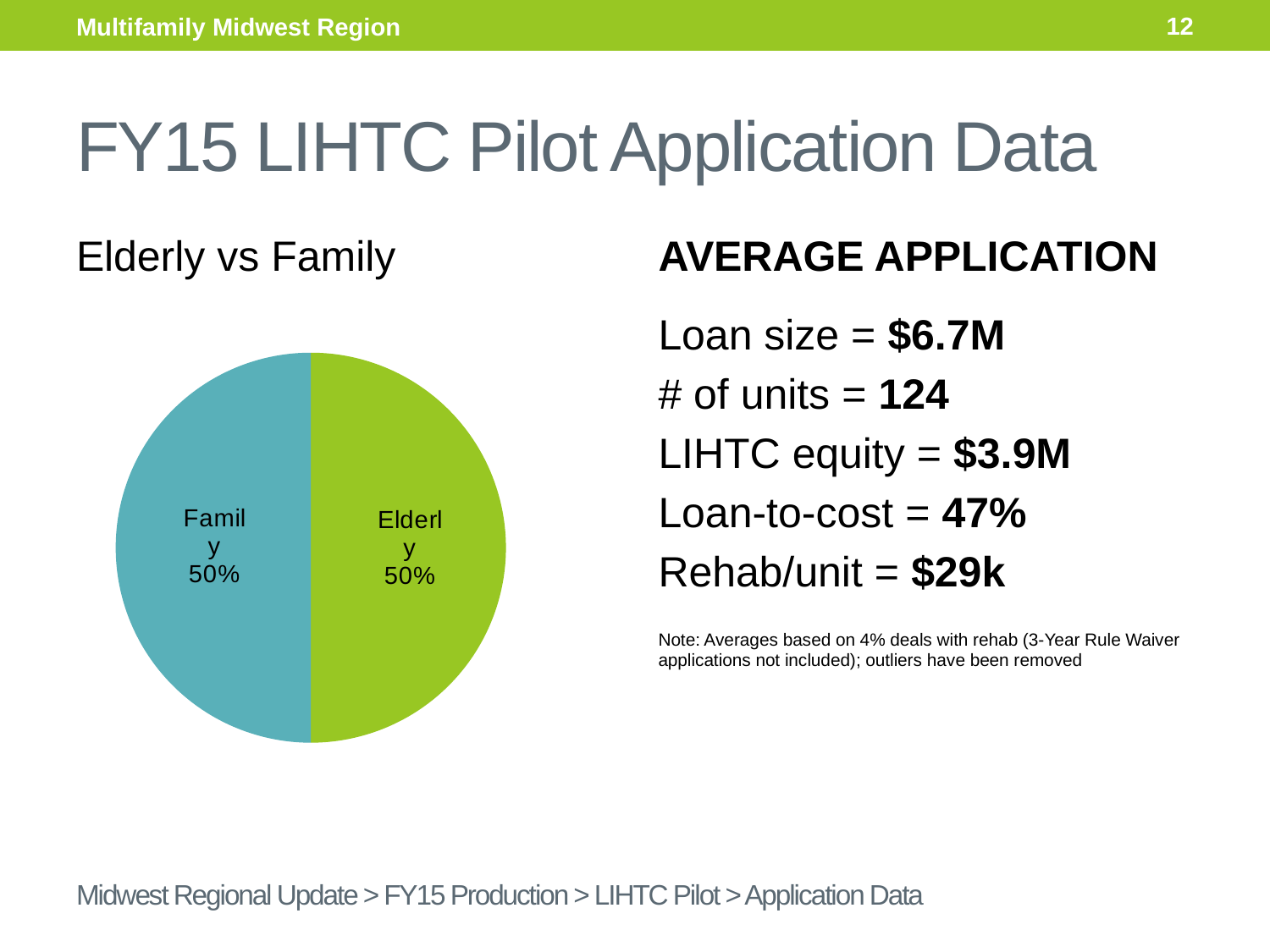
What is the value shown for the Elderly slice? 50% What is the title of the pie chart? Elderly vs Family Is the value for Family greater or less than 40%? greater What kind of chart is shown on the slide? pie chart What share of the pie does the Elderly slice represent? 50% What colour is the Family slice of the pie chart? teal (blue-green) What is the value shown for the Family slice? 50% What is the difference between the Family and Elderly shares? 0% How many slices does the pie chart have? 2 What share of the pie does the Family slice represent? 50% Is the value for Elderly greater or less than 60%? less